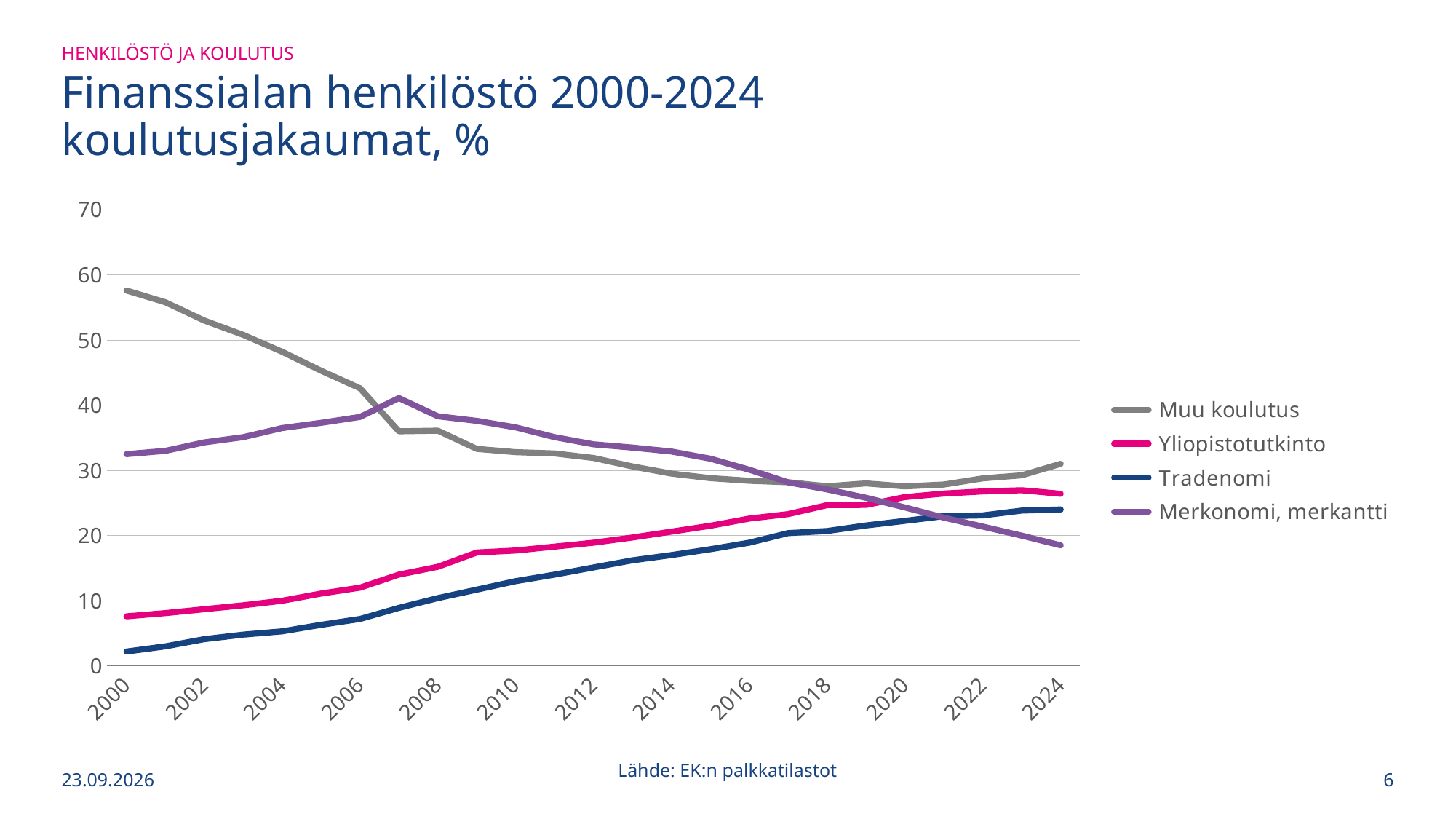
How many series does the legend list? 4 In 2024, which is larger: Yliopistotutkinto or Merkonomi, merkantti? Yliopistotutkinto Is the value for Tradenomi in 2000 greater or less than 10? less Does the Merkonomi, merkantti line rise or fall from 2008 to 2024? fall Is the value for Yliopistotutkinto in 2024 greater or less than 20? greater Which series has the highest value in 2000? Muu koulutus Which series has the lowest value in 2000? Tradenomi What source is cited below the chart? EK:n palkkatilastot What kind of chart is shown on the slide? line chart Is the value for Muu koulutus in 2000 greater or less than 50? greater Does the Tradenomi line rise or fall from 2000 to 2024? rise